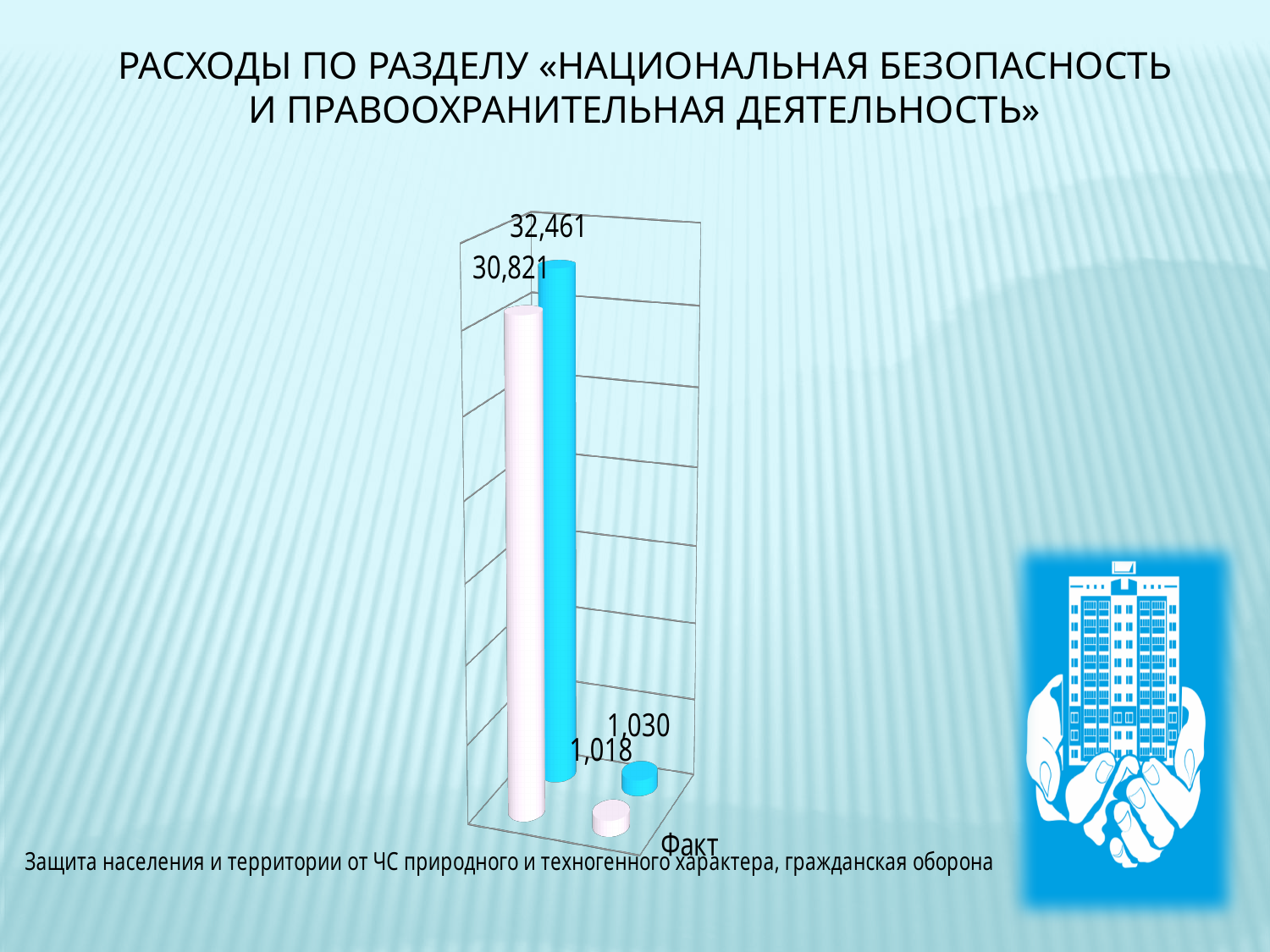
Which of the two tall bars is larger, the blue one or the white one? the blue one (32,461) What is the highest value labelled on the chart? 32,461 What value is labelled on the short white bar? 1,018 What is the lowest value labelled on the chart? 1,018 What value is labelled on the tall white bar? 30,821 How many bars are plotted on the chart? 4 What is the difference between the short blue bar (1,030) and the short white bar (1,018)? 12 What kind of chart is shown on the slide? bar chart What value is labelled on the short blue bar? 1,030 What is the difference between the tall blue bar (32,461) and the tall white bar (30,821)? 1,640 What is the title of the slide containing the chart? РАСХОДЫ ПО РАЗДЕЛУ «НАЦИОНАЛЬНАЯ БЕЗОПАСНОСТЬ И ПРАВООХРАНИТЕЛЬНАЯ ДЕЯТЕЛЬНОСТЬ» What value is labelled on the tall blue bar? 32,461